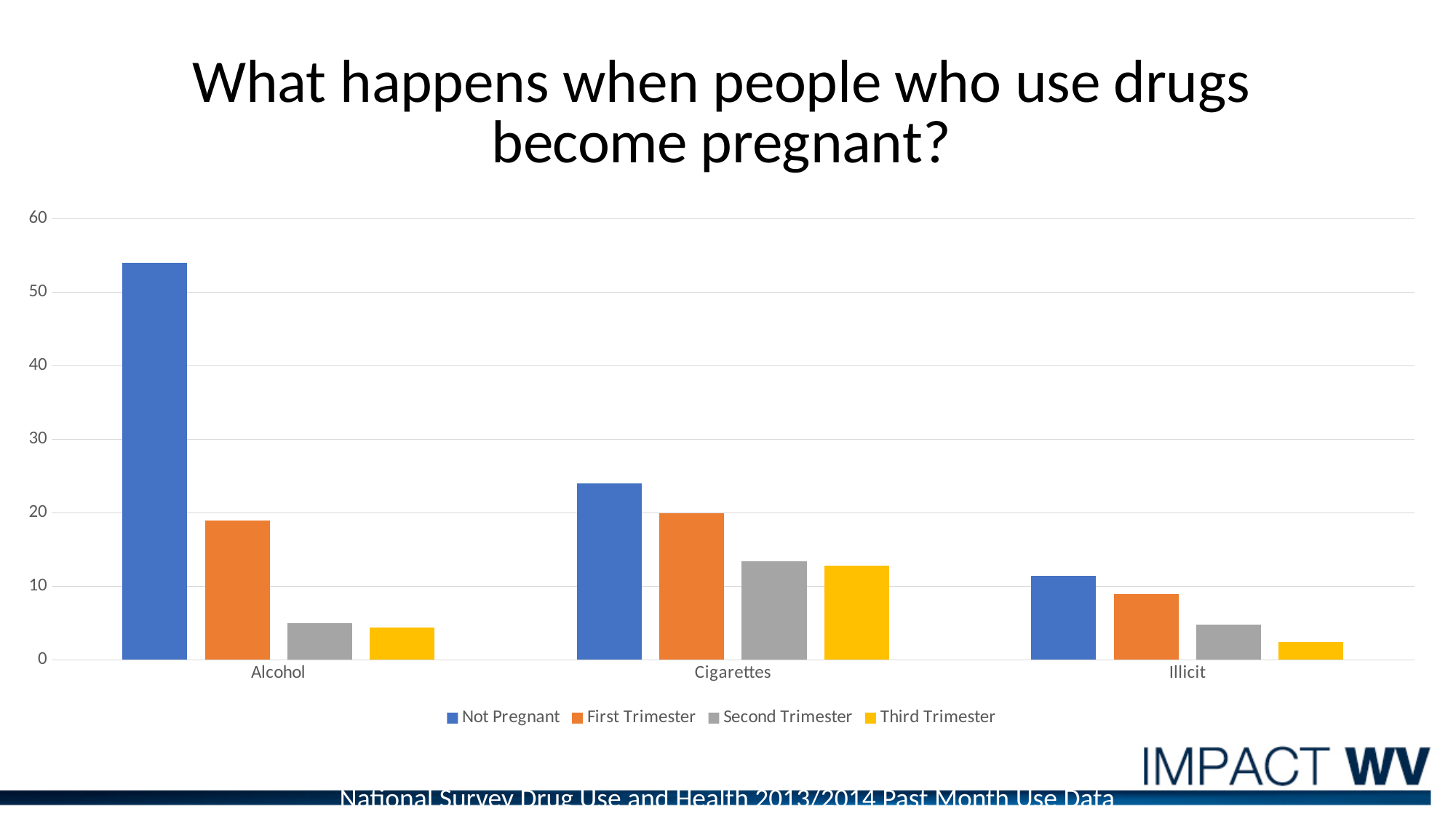
What is the title of the chart on the slide? What happens when people who use drugs become pregnant? What kind of chart is shown on the slide? bar chart Is the Not Pregnant value for Cigarettes greater or less than 20? greater Is the First Trimester value for Illicit greater or less than 10? less How many series does the legend list? 4 Which series is shown in yellow in the legend? Third Trimester Which category has the lowest Third Trimester value? Illicit Is the Not Pregnant value for Alcohol greater or less than 50? greater Which category has the highest Not Pregnant value? Alcohol How many categories are shown on the x axis? 3 Which is larger for Cigarettes: the Not Pregnant value or the Second Trimester value? Not Pregnant